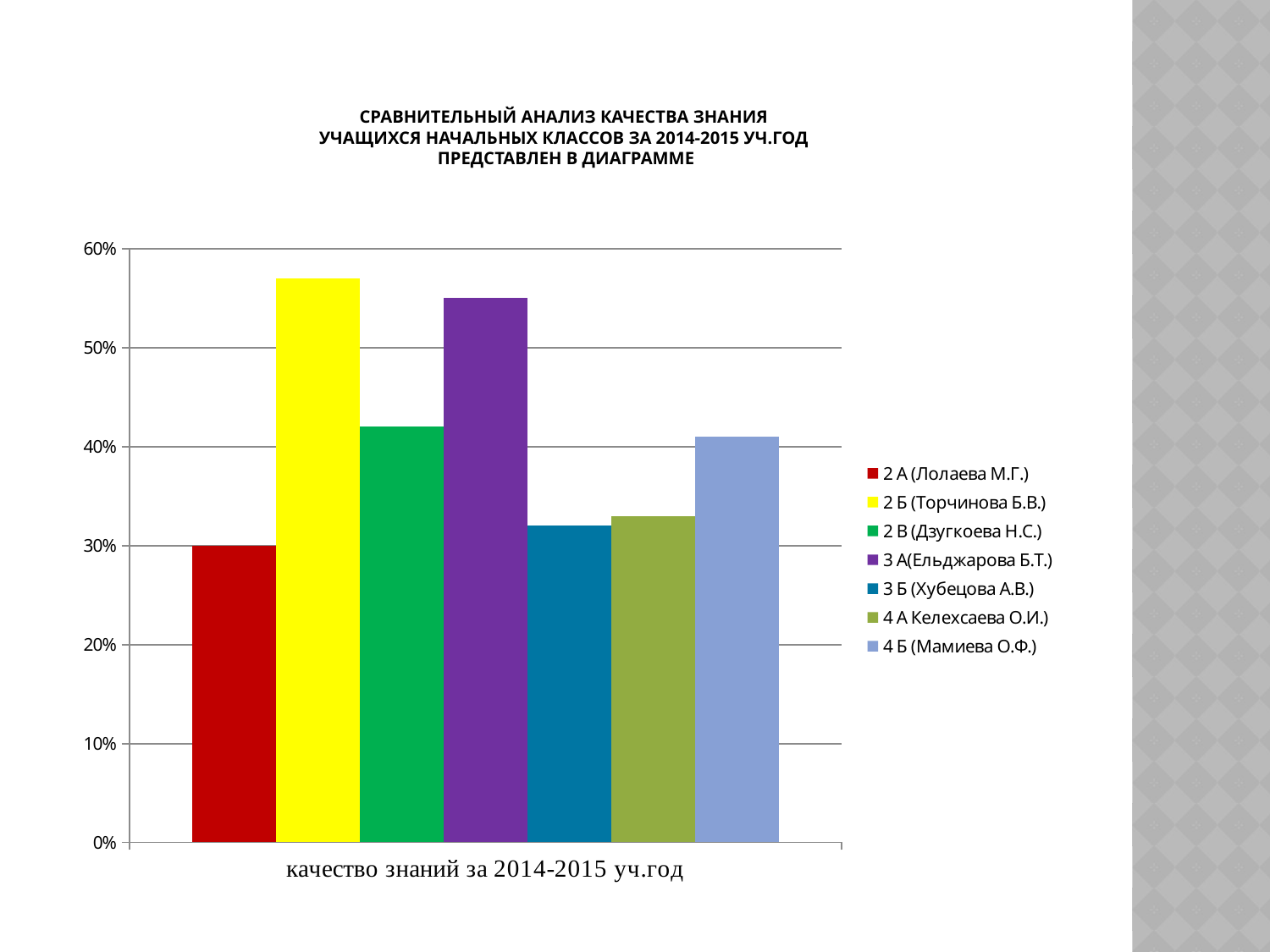
Is the value for 4 А Келехсаева О.И.) greater or less than 40%? less Which series has the lowest value? 2 А (Лолаева М.Г.) Which is larger, the value for 2 Б (Торчинова Б.В.) or the value for 2 В (Дзугкоева Н.С.)? 2 Б (Торчинова Б.В.) How many series does the legend list? 7 Which is larger, the value for 4 Б (Мамиева О.Ф.) or the value for 3 Б (Хубецова А.В.)? 4 Б (Мамиева О.Ф.) Which series has the highest value? 2 Б (Торчинова Б.В.) How many categories are shown on the x axis? 1 What is the category label shown on the x axis? качество знаний за 2014-2015 уч.год Is the value for 3 А(Ельджарова Б.Т.) greater or less than 50%? greater What kind of chart is shown on the slide? bar chart What is the value for 2 А (Лолаева М.Г.)? 30% Is the value for 2 В (Дзугкоева Н.С.) greater or less than 40%? greater